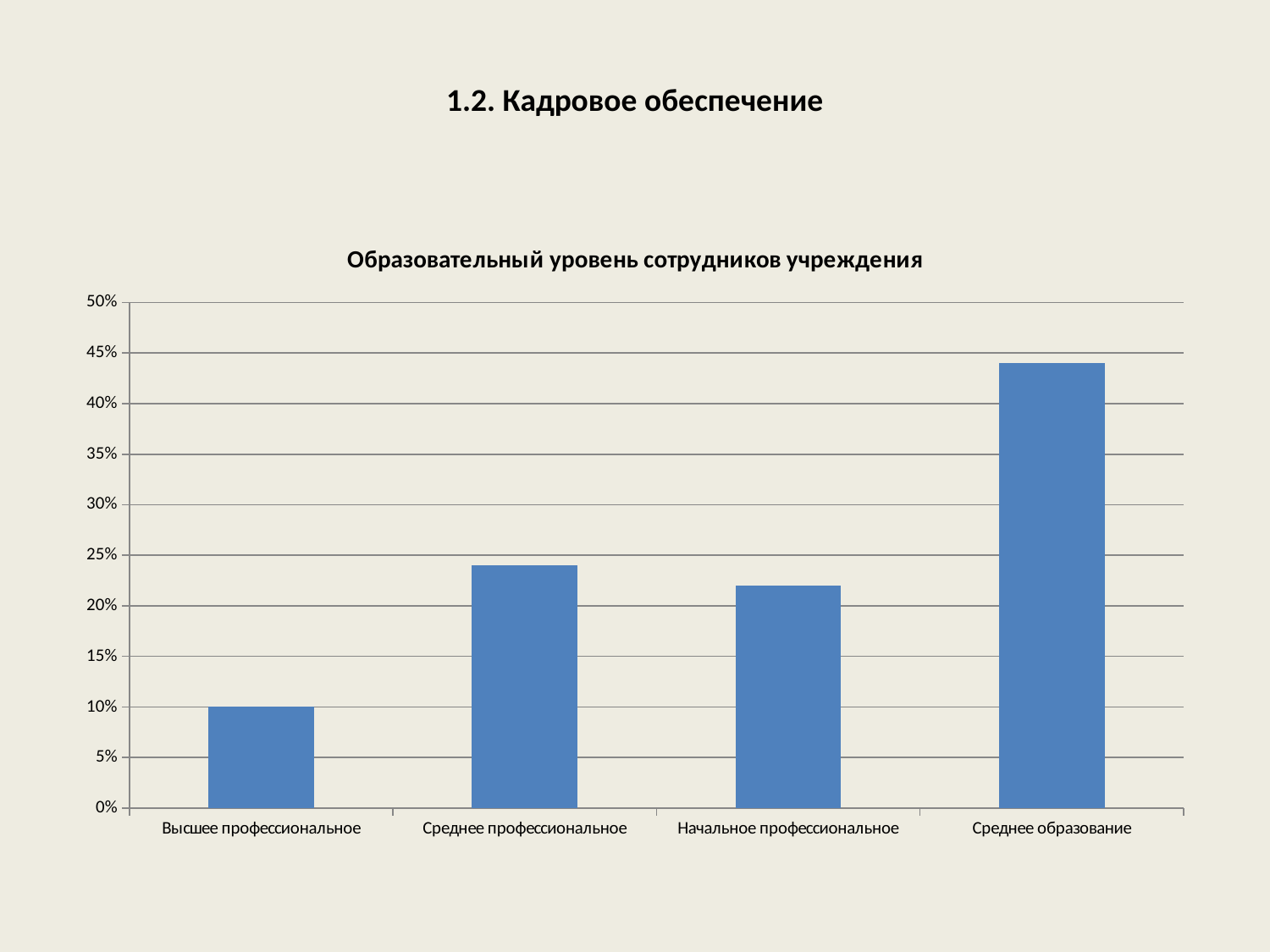
How many categories are shown on the x axis of the chart? 4 Is the value for Среднее образование greater or less than 40%? greater Which is larger, the value for Среднее образование or the value for Среднее профессиональное? Среднее образование What type of chart is shown on the slide? Bar chart Which category has the highest value? Среднее образование What is the title of the chart? Образовательный уровень сотрудников учреждения Which is larger, the value for Высшее профессиональное or the value for Начальное профессиональное? Начальное профессиональное Is the value for Среднее образование greater or less than 45%? less What is the value for Высшее профессиональное? 10% Is the value for Среднее профессиональное greater or less than 25%? less Which category has the lowest value? Высшее профессиональное